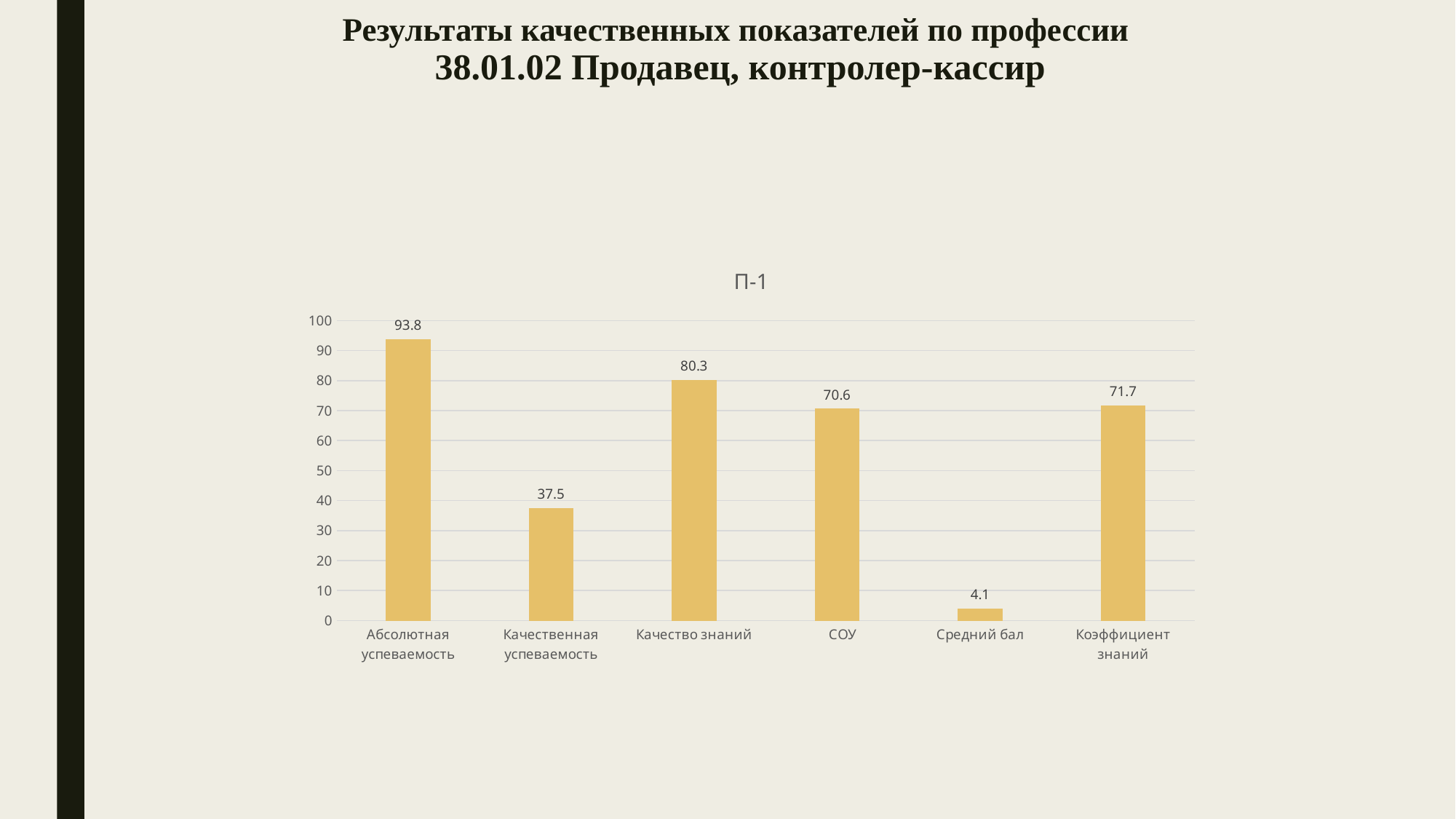
What is the value for Качественная успеваемость? 37.5 How many categories are shown on the x axis? 6 What is the title of the chart? П-1 What is the difference between the values for Абсолютная успеваемость and Качественная успеваемость? 56.3 Which category has the highest value? Абсолютная успеваемость What is the value for СОУ? 70.6 What is the value for Качество знаний? 80.3 Which is larger, the value for Качество знаний or the value for СОУ? Качество знаний What is the value for Средний бал? 4.1 What is the value for Абсолютная успеваемость? 93.8 What is the value for Коэффициент знаний? 71.7 Which category has the lowest value? Средний бал